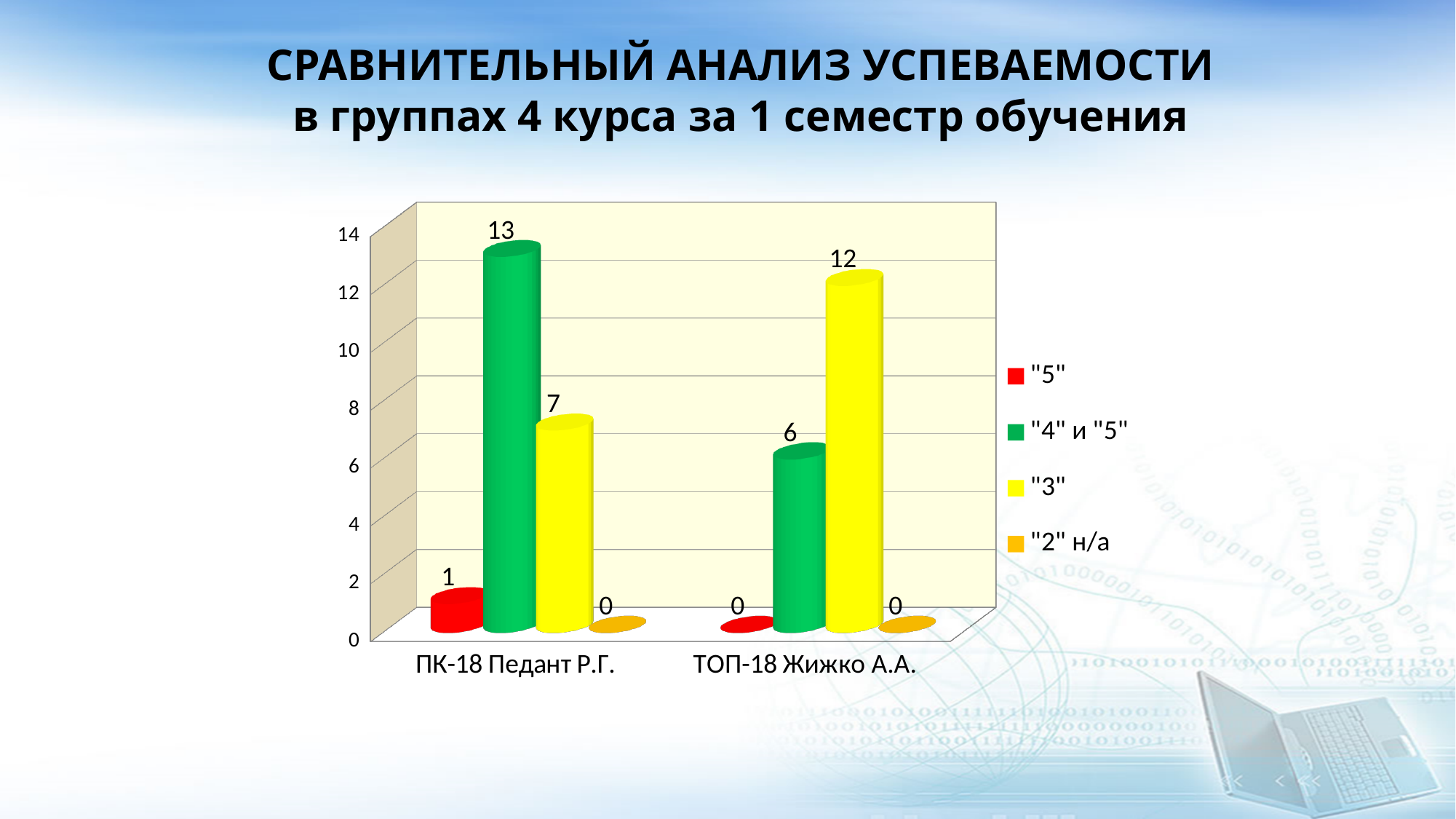
What is the value for "3" in the ТОП-18 Жижко А.А. group? 12 What is the value for "5" in the ПК-18 Педант Р.Г. group? 1 Which series has the highest value in the ТОП-18 Жижко А.А. group? "3" What is the difference between the "4" и "5" values of ПК-18 Педант Р.Г. and ТОП-18 Жижко А.А.? 7 Which group has the larger value for "3": ПК-18 Педант Р.Г. or ТОП-18 Жижко А.А.? ТОП-18 Жижко А.А. How many series does the legend list? 4 What is the value for "4" и "5" in the ПК-18 Педант Р.Г. group? 13 How many groups (categories) are shown on the x axis? 2 What kind of chart is shown on the slide? Bar chart Which series has the highest value in the ПК-18 Педант Р.Г. group? "4" и "5" What is the difference between the "3" values of ТОП-18 Жижко А.А. and ПК-18 Педант Р.Г.? 5 What is the value for "4" и "5" in the ТОП-18 Жижко А.А. group? 6